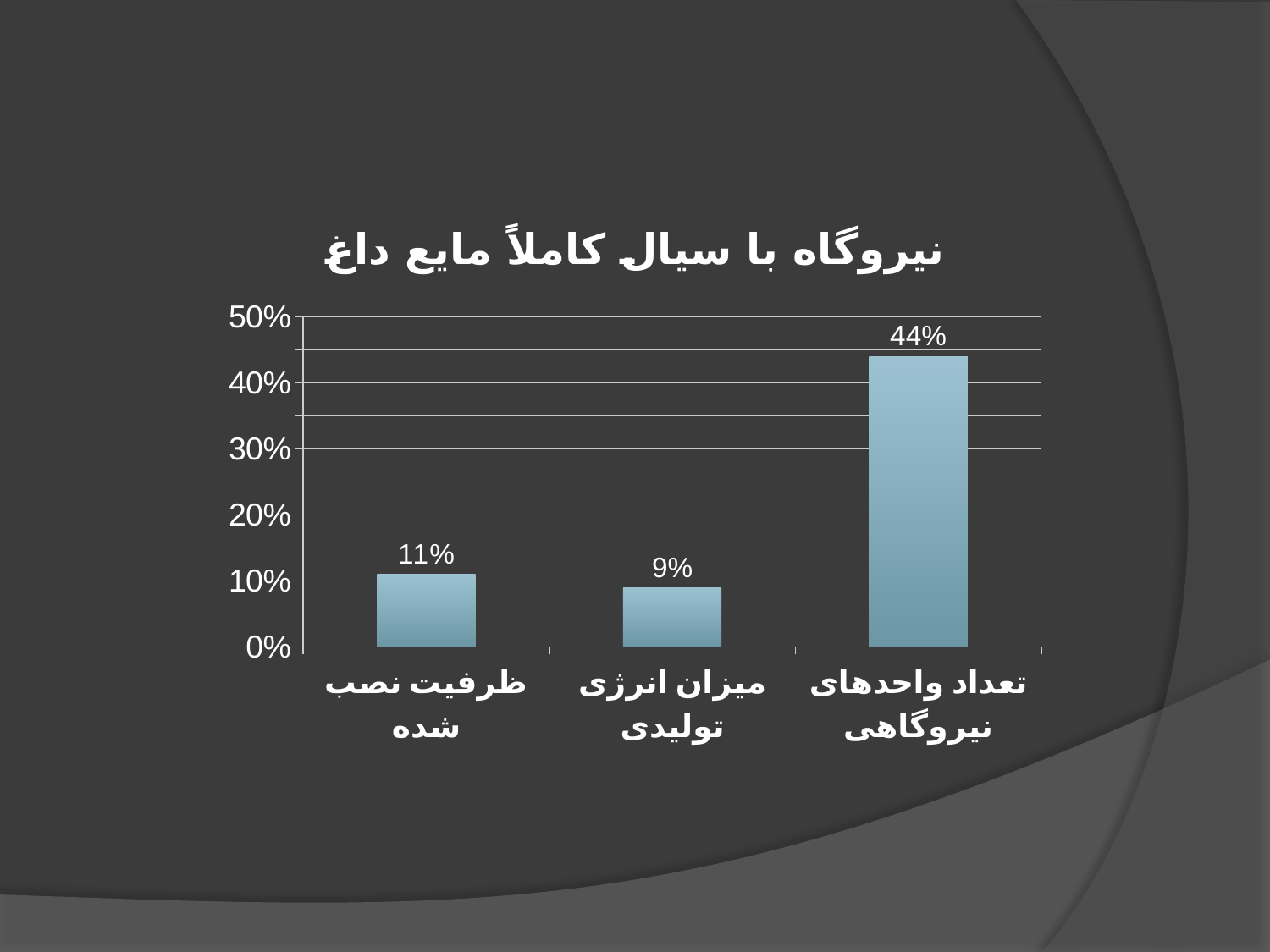
What is the value for میزان انرژی تولیدی? 9% What is the title of the chart? نیروگاه با سیال کاملاً مایع داغ What is the value for تعداد واحدهای نیروگاهی? 44% How many categories are shown on the x axis? 3 Which category has the lowest value? میزان انرژی تولیدی Which category has the highest value? تعداد واحدهای نیروگاهی Which is larger, the value for ظرفیت نصب شده or the value for میزان انرژی تولیدی? ظرفیت نصب شده What is the difference between the values for ظرفیت نصب شده and میزان انرژی تولیدی? 2% What is the difference between the values for تعداد واحدهای نیروگاهی and ظرفیت نصب شده? 33% Is the value for تعداد واحدهای نیروگاهی greater or less than 40%? greater What is the value for ظرفیت نصب شده? 11% What kind of chart is shown on the slide? bar chart